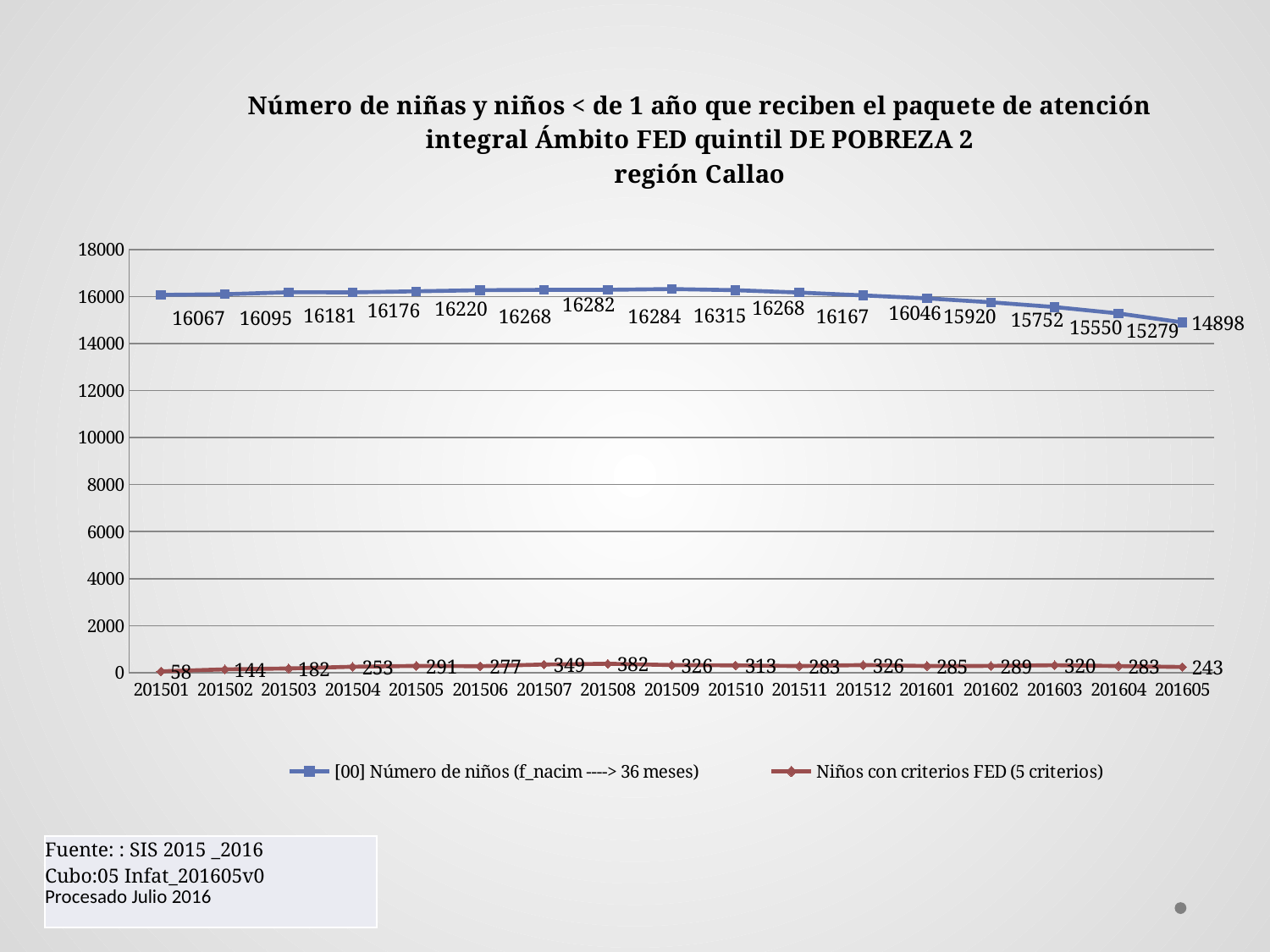
What is the difference between the '[00] Número de niños' value at 201501 and at 201605? 1169 How many series does the legend list? 2 What is the value of 'Niños con criterios FED (5 criterios)' at 201603? 320 What is the value of 'Niños con criterios FED (5 criterios)' at 201508? 382 In which month does the series '[00] Número de niños (f_nacim ----> 36 meses)' reach its highest value? 201509 Which is larger for 'Niños con criterios FED (5 criterios)': the value at 201507 or at 201509? 201507 Does the series '[00] Número de niños (f_nacim ----> 36 meses)' rise or fall from 201509 to 201605? fall What is the value of the series '[00] Número de niños (f_nacim ----> 36 meses)' at 201501? 16067 In which month does the series '[00] Número de niños (f_nacim ----> 36 meses)' have its lowest value? 201605 By how much does 'Niños con criterios FED (5 criterios)' at 201508 exceed its value at 201501? 324 In which month is 'Niños con criterios FED (5 criterios)' lowest? 201501 How many months are plotted along the x axis? 17